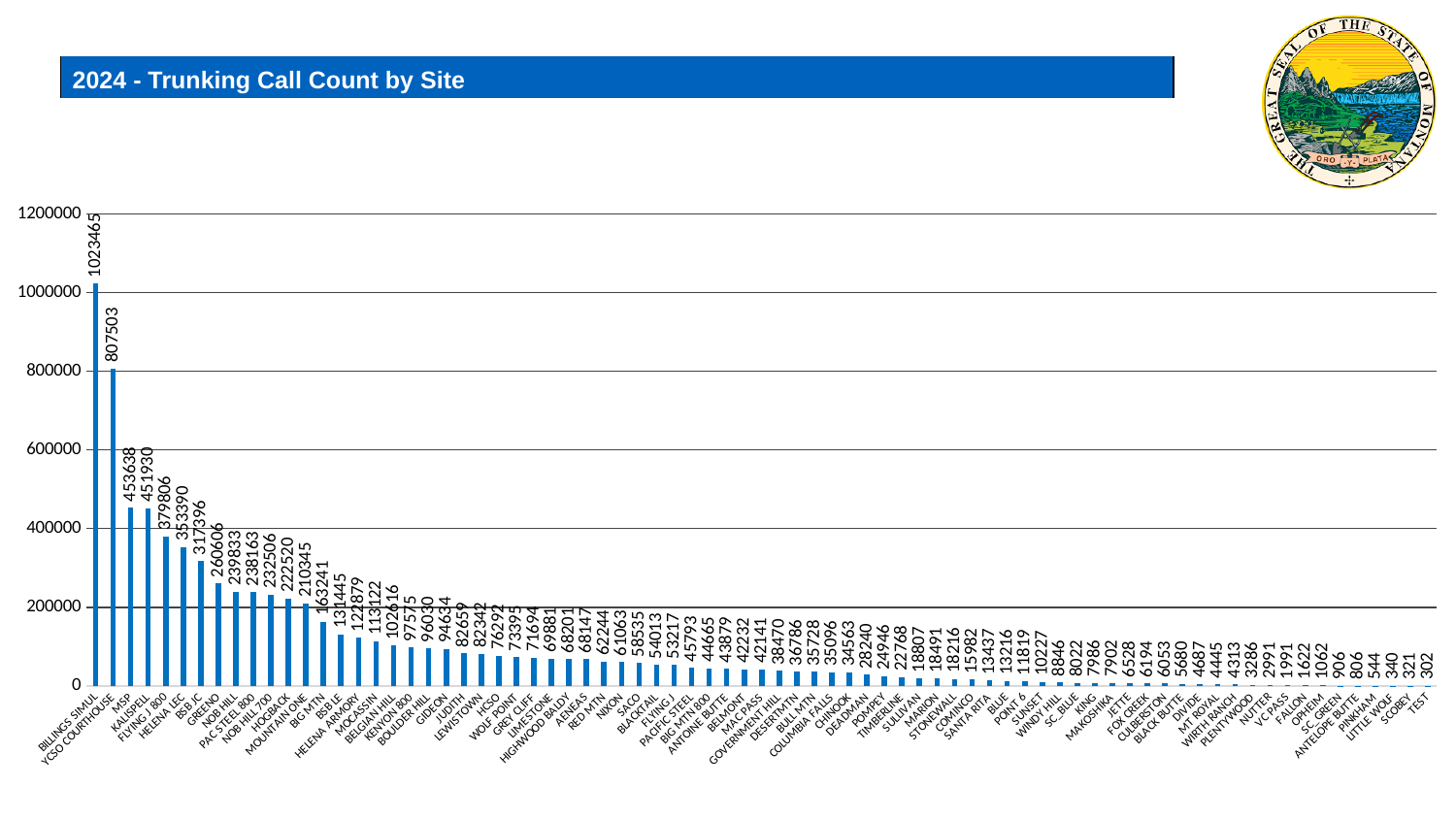
Is the value for YCSO COURTHOUSE greater or less than 800000? greater What is the title of the chart? 2024 - Trunking Call Count by Site What kind of chart is shown on the slide? Bar chart Do the call counts rise or fall moving from left to right along the x axis? Fall What is the trunking call count for TEST? 302 Which site has the lowest trunking call count? TEST What is the trunking call count for MSP? 453638 What is the difference in call count between BILLINGS SIMUL and YCSO COURTHOUSE? 215962 Which site has the highest trunking call count? BILLINGS SIMUL Which site has a larger call count, MSP or KALISPELL? MSP What is the trunking call count for YCSO COURTHOUSE? 807503 What is the trunking call count for BILLINGS SIMUL? 1023465